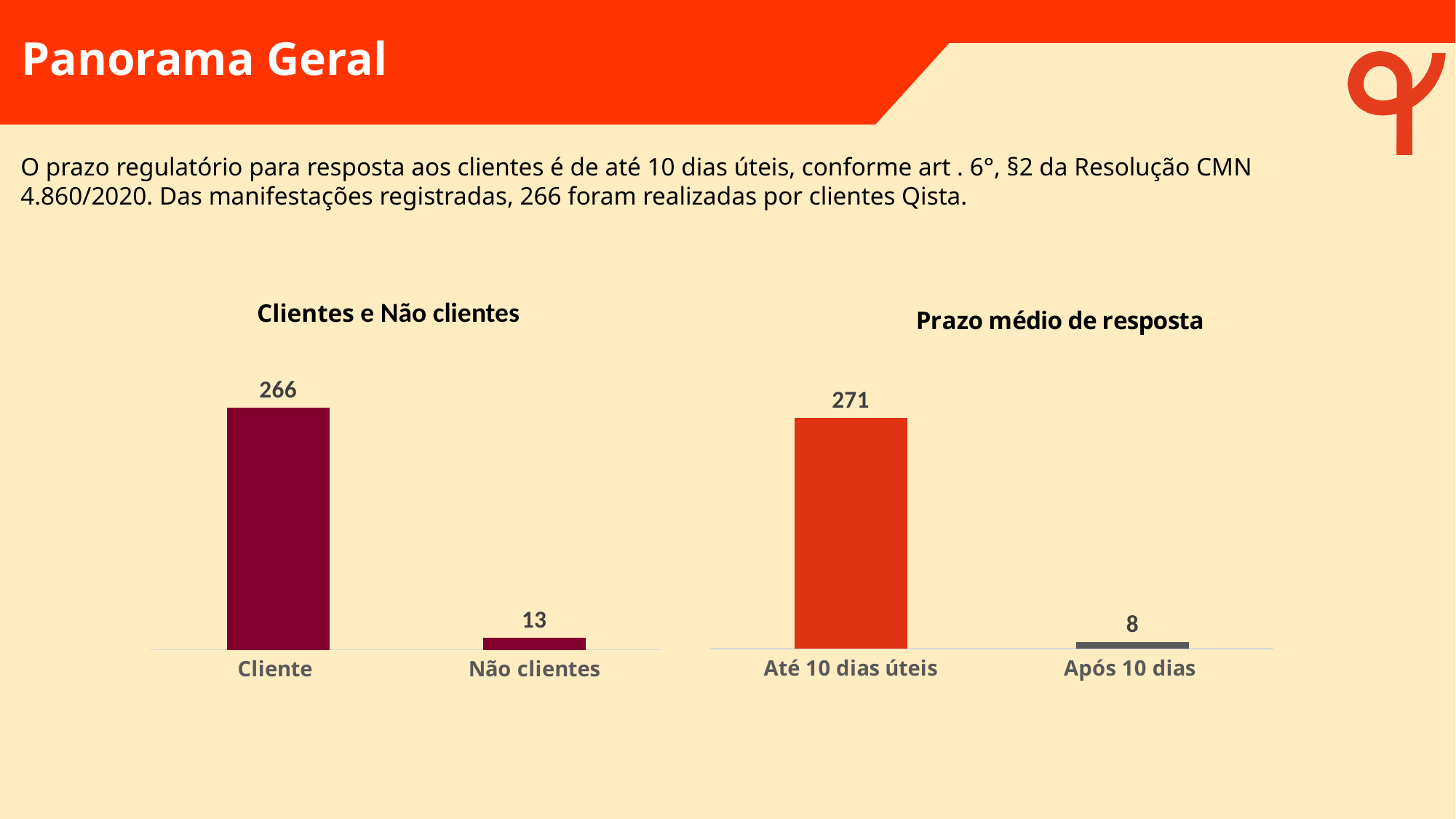
In the 'Clientes e Não clientes' chart, what is the value for Não clientes? 13 What kind of chart is the 'Prazo médio de resposta' chart? Bar chart In the 'Prazo médio de resposta' chart, which category has the lowest value? Após 10 dias How many categories does the 'Clientes e Não clientes' chart show? 2 In the 'Clientes e Não clientes' chart, which category has the highest value? Cliente What is the title of the chart on the left side of the slide? Clientes e Não clientes In the 'Clientes e Não clientes' chart, what is the value for Cliente? 266 In the 'Prazo médio de resposta' chart, what is the value for Até 10 dias úteis? 271 In the 'Prazo médio de resposta' chart, what is the value for Após 10 dias? 8 In the 'Prazo médio de resposta' chart, which is larger: Até 10 dias úteis or Após 10 dias? Até 10 dias úteis In the 'Prazo médio de resposta' chart, what is the difference between the values for Até 10 dias úteis and Após 10 dias? 263 In the 'Clientes e Não clientes' chart, what is the difference between the values for Cliente and Não clientes? 253